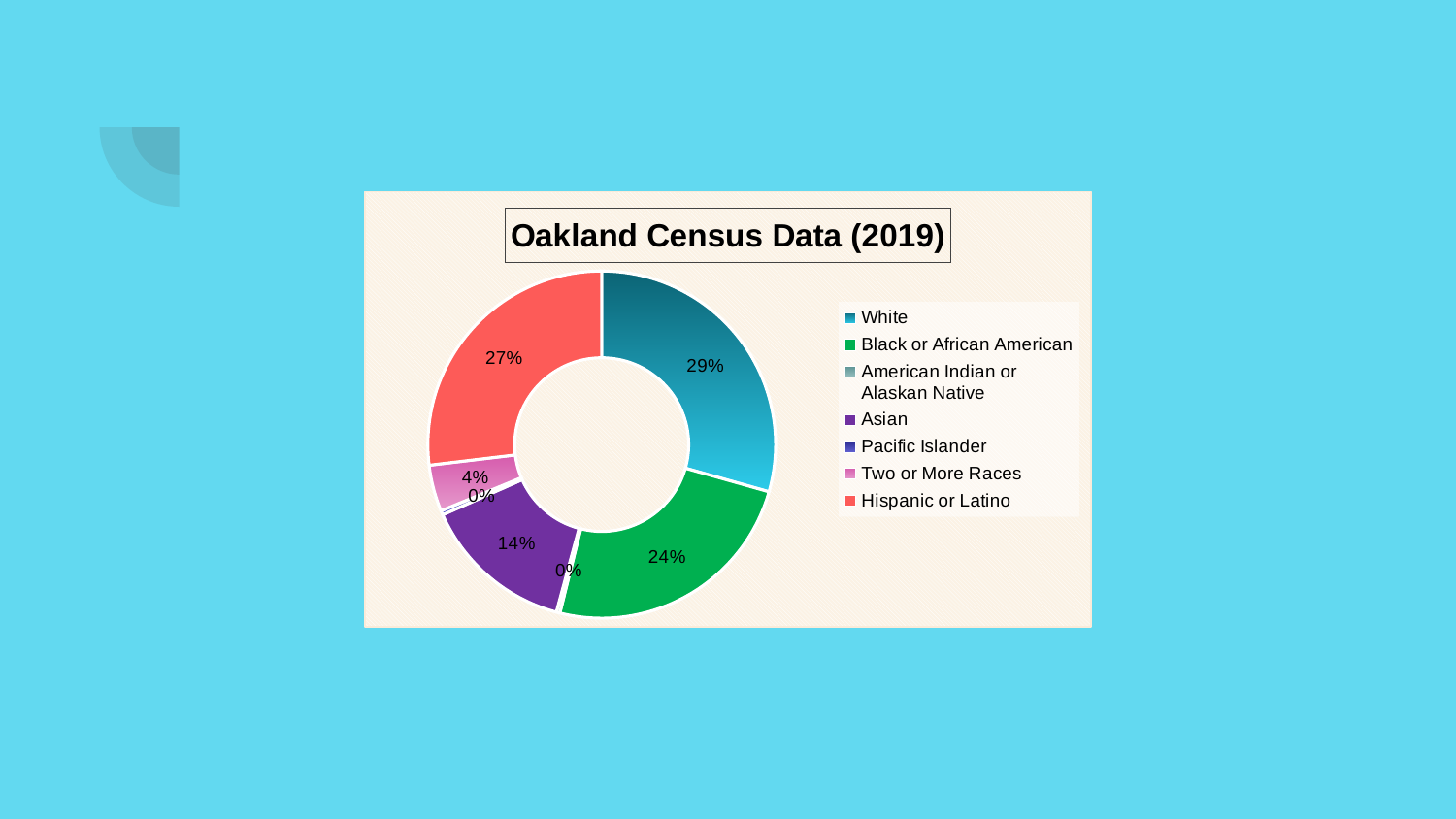
Which is larger, the share for Hispanic or Latino or the share for Black or African American? Hispanic or Latino What is the title of the chart? Oakland Census Data (2019) What is the difference between the White share and the Black or African American share? 5% What colour is the Hispanic or Latino slice? Red What percentage is shown for Asian? 14% How many categories does the legend list? 7 What kind of chart is shown on the slide? Doughnut chart What percentage is shown for Hispanic or Latino? 27% What percentage is shown for Black or African American? 24% What percentage is shown for Two or More Races? 4% Which category has the largest share of the chart? White What percentage is shown for White? 29%